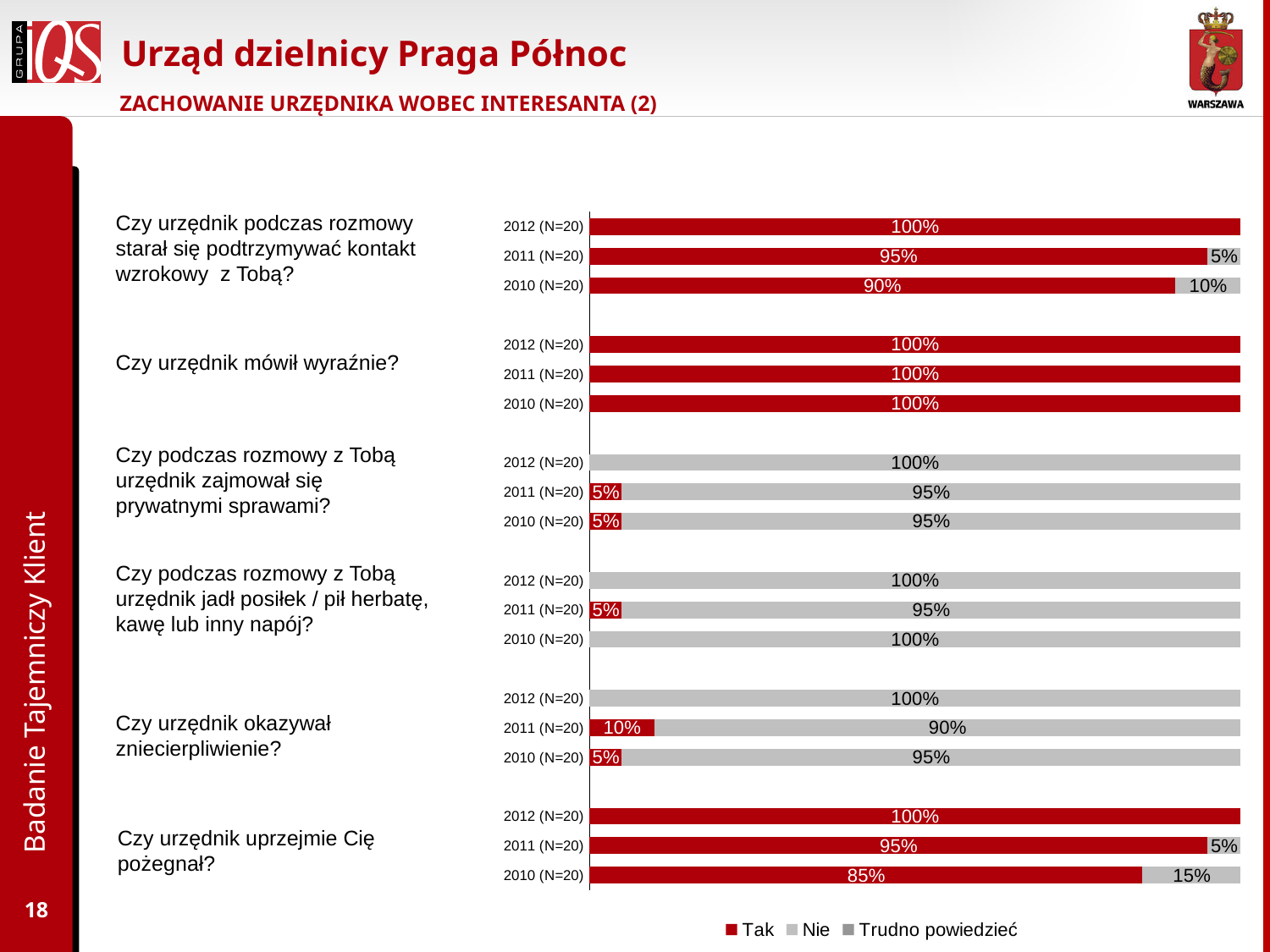
For the question 'Czy urzędnik okazywał zniecierpliwienie?', what is the 'Tak' value for 2011 (N=20)? 10% For the question 'Czy urzędnik uprzejmie Cię pożegnał?', what is the 'Tak' value for 2010 (N=20)? 85% For the question 'Czy urzędnik podczas rozmowy starał się podtrzymywać kontakt wzrokowy z Tobą?', what is the 'Tak' value for 2010 (N=20)? 90% How many series does the legend list? 3 For the question 'Czy urzędnik podczas rozmowy starał się podtrzymywać kontakt wzrokowy z Tobą?', does the 'Tak' value rise or fall from 2010 to 2012? rise What are the legend entries of the chart? Tak, Nie, Trudno powiedzieć For the question 'Czy urzędnik mówił wyraźnie?', what is the 'Tak' value for 2011 (N=20)? 100% For the question 'Czy urzędnik uprzejmie Cię pożegnał?', what is the difference between the 'Tak' values for 2012 (N=20) and 2010 (N=20)? 15% For the question 'Czy urzędnik okazywał zniecierpliwienie?', which year has the highest 'Tak' value? 2011 (N=20) For the question 'Czy urzędnik uprzejmie Cię pożegnał?', what is the 'Nie' value for 2010 (N=20)? 15% What kind of chart is shown on the slide? stacked bar chart For the question 'Czy urzędnik podczas rozmowy starał się podtrzymywać kontakt wzrokowy z Tobą?', what is the 'Nie' value for 2011 (N=20)? 5%